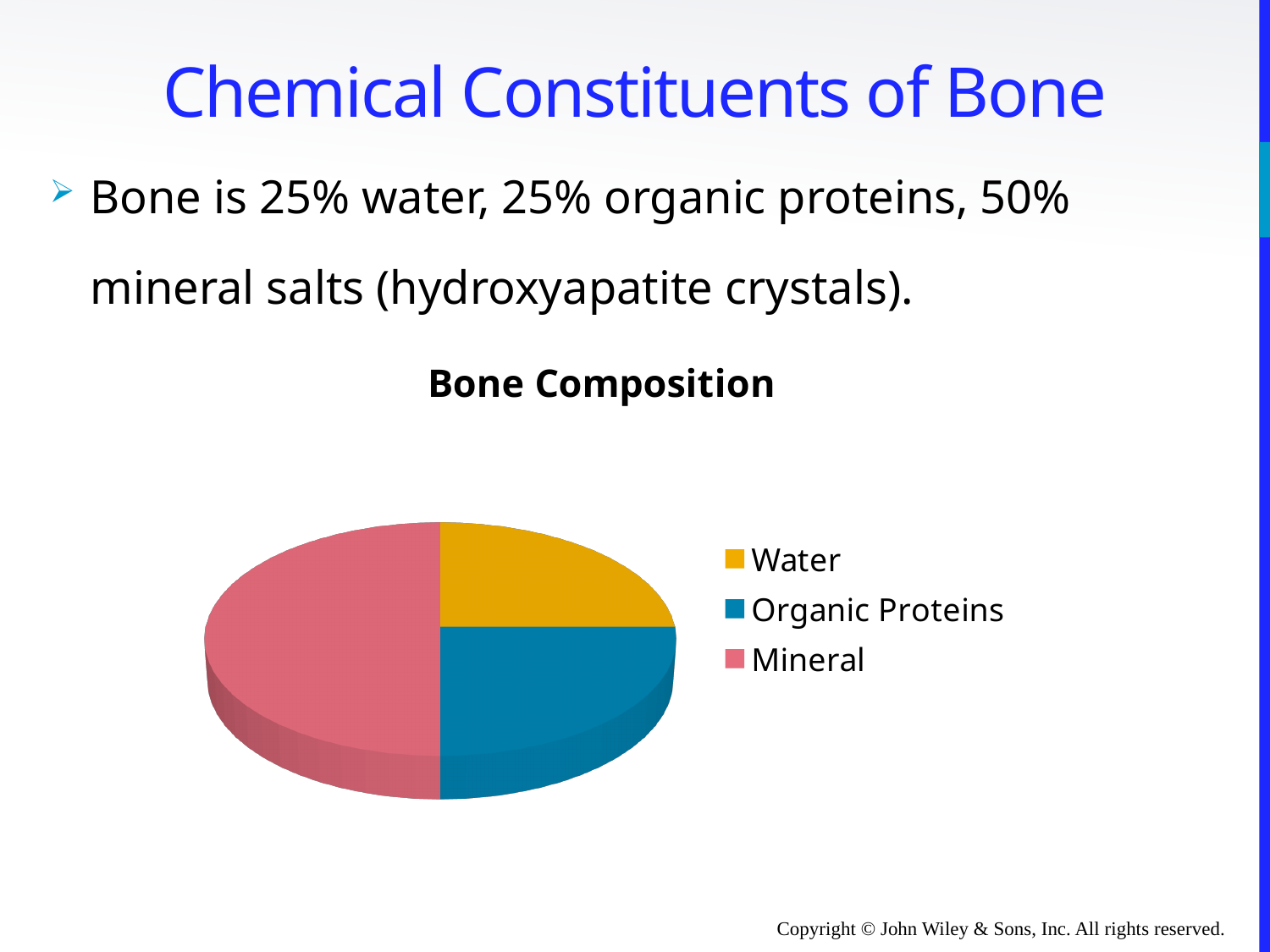
What share of the pie does Organic Proteins represent? 25% Which is larger, the Mineral slice or the Water slice? Mineral How many entries does the legend list? 3 What kind of chart is shown on the slide? pie chart Which is larger, the Mineral slice or the Organic Proteins slice? Mineral What is the title of the chart? Bone Composition Which category has the largest slice of the pie? Mineral What colour is the Mineral slice in the pie chart? pink What share of the pie does Water represent? 25% What share of the pie does Mineral represent? 50% How many slices does the pie chart have? 3